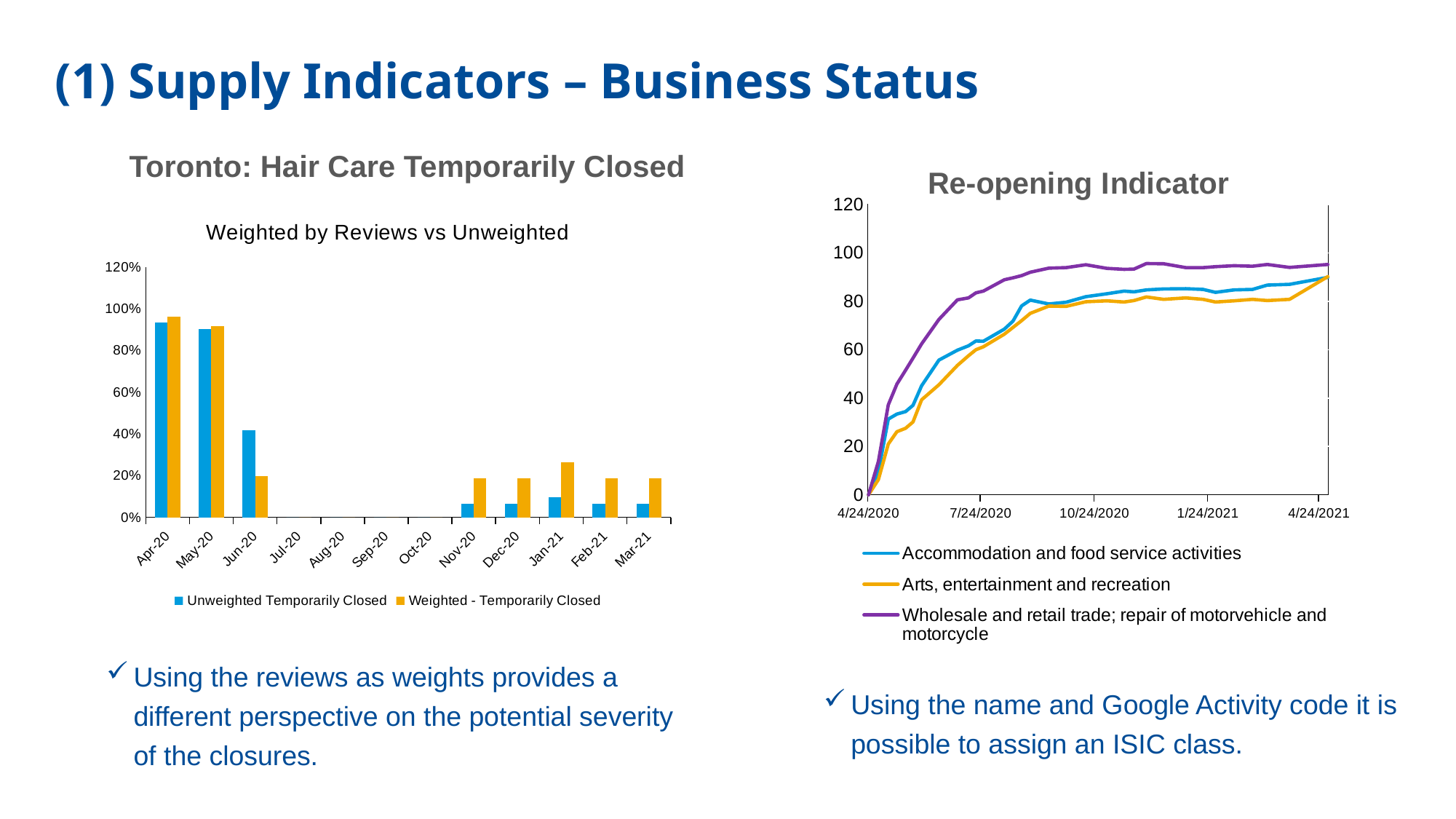
What kind of chart is the "Re-opening Indicator" chart? line chart In the "Re-opening Indicator" chart, do the lines generally rise or fall from 4/24/2020 to 4/24/2021? rise What kind of chart is the left chart titled "Weighted by Reviews vs Unweighted"? bar chart In the "Weighted by Reviews vs Unweighted" chart, is the Unweighted Temporarily Closed value for Apr-20 greater or less than 80%? greater How many series does the legend of the "Weighted by Reviews vs Unweighted" chart list? 2 In the "Weighted by Reviews vs Unweighted" chart, is the Weighted - Temporarily Closed value for Jun-20 greater or less than 40%? less In the "Re-opening Indicator" chart, is the value for Wholesale and retail trade; repair of motorvehicle and motorcycle at 7/24/2020 greater or less than 60? greater How many series does the legend of the "Re-opening Indicator" chart list? 3 How many months are shown on the x axis of the "Weighted by Reviews vs Unweighted" chart? 12 In the "Weighted by Reviews vs Unweighted" chart, which month has the highest Weighted - Temporarily Closed value? Apr-20 In the "Re-opening Indicator" chart, which series has the highest value at 4/24/2021? Wholesale and retail trade; repair of motorvehicle and motorcycle In the "Weighted by Reviews vs Unweighted" chart, which is larger for Jun-20: Unweighted Temporarily Closed or Weighted - Temporarily Closed? Unweighted Temporarily Closed